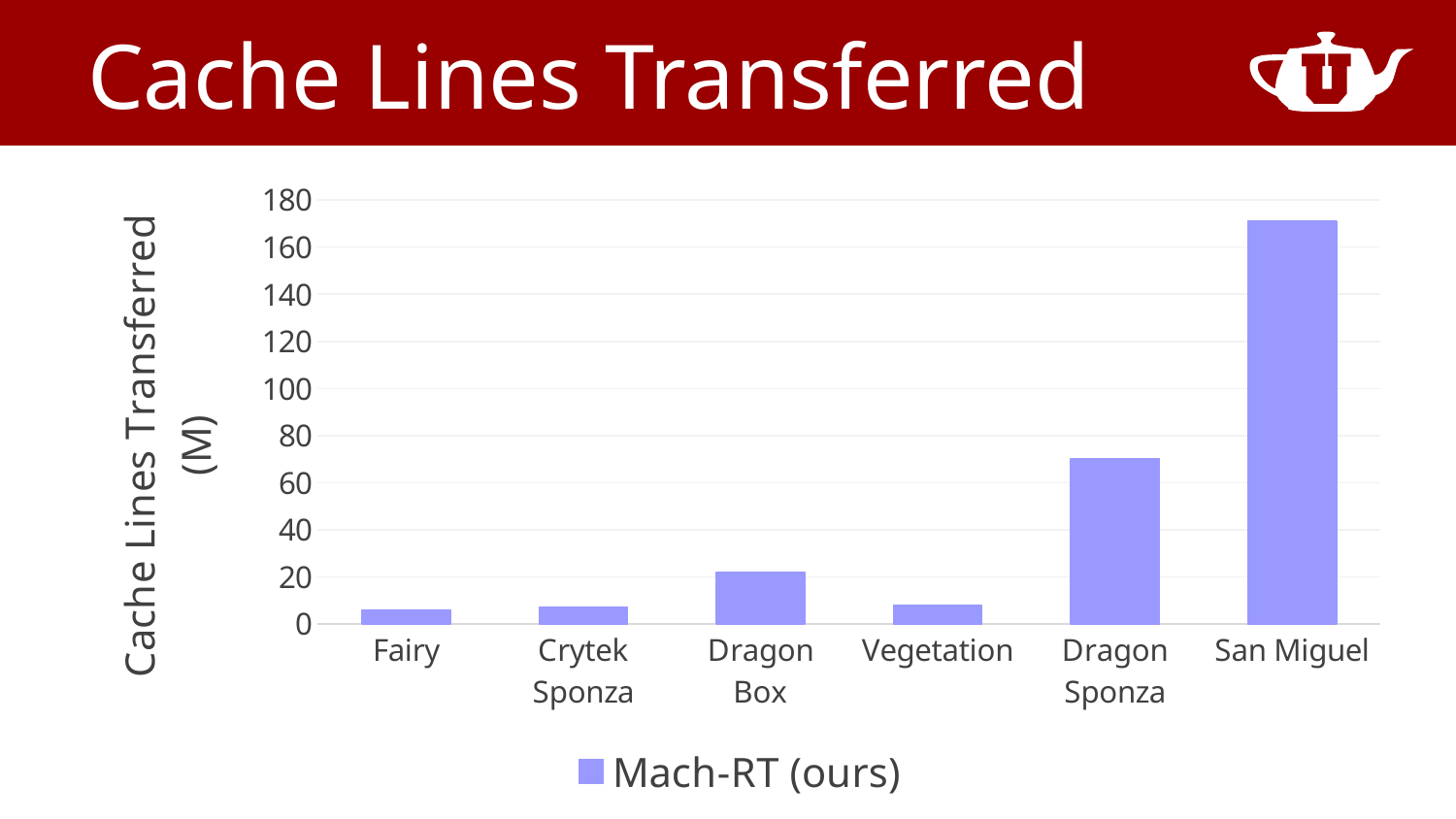
Is the value for Vegetation greater or less than 20? less Is the value for San Miguel greater or less than 160? greater How many series does the legend list? 1 Is the value for Dragon Box greater or less than 40? less Which category has the highest number of cache lines transferred? San Miguel Which is larger, the value for Dragon Box or the value for Vegetation? Dragon Box How many categories are shown on the x axis of the chart? 6 Which is larger, the value for Dragon Sponza or the value for San Miguel? San Miguel What is the name of the series shown in the legend? Mach-RT (ours) What kind of chart is shown on the slide? bar chart